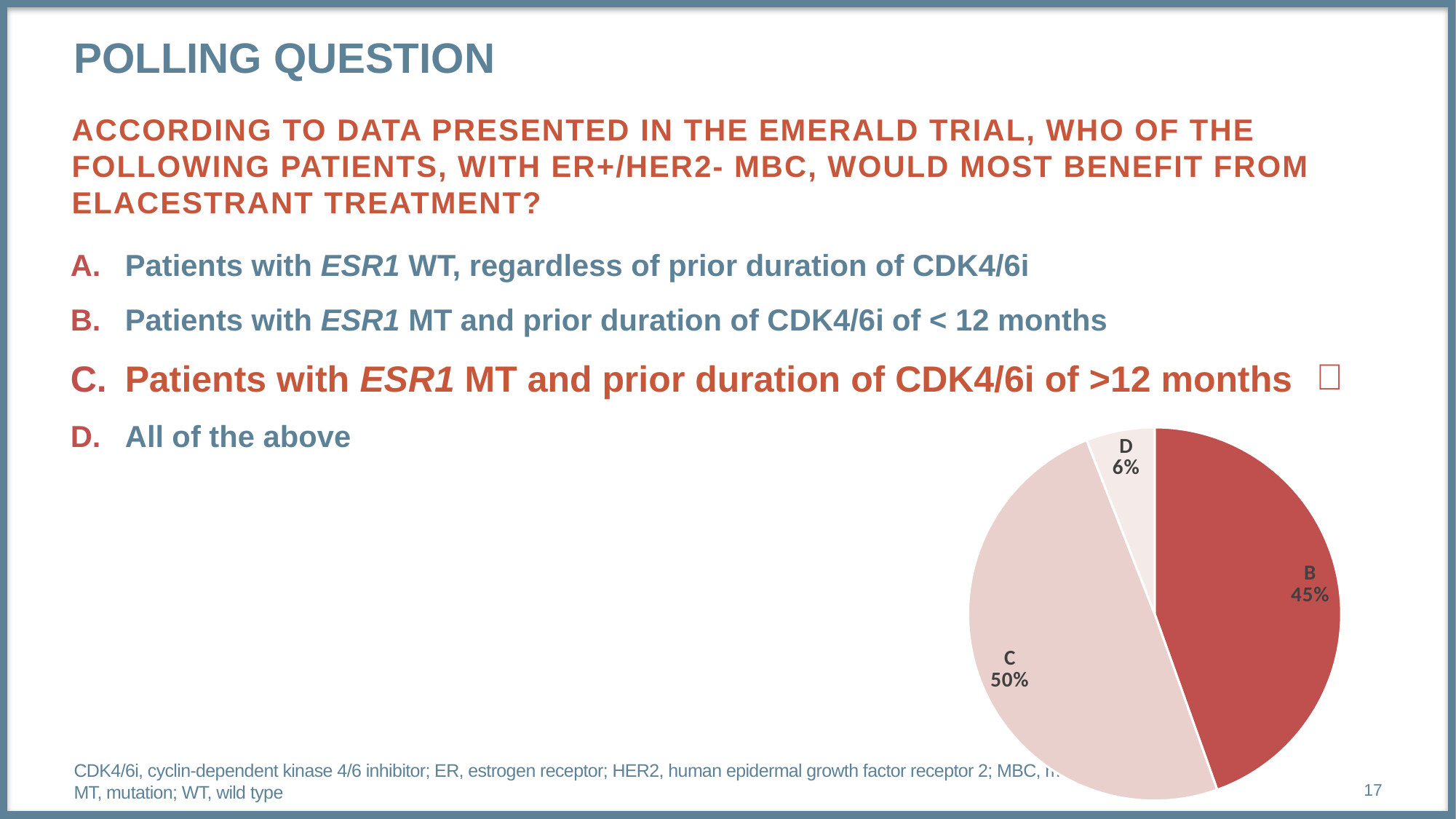
What kind of chart is shown on the slide? pie chart What share of the pie chart does option D have? 6% Which slice is larger in the pie chart, C or B? C What share of the pie chart does option B have? 45% How many slices are labelled in the pie chart? 3 Which option has the smallest slice in the pie chart? D What is the difference in percentage points between the slices for B and D? 39% Which slice is larger in the pie chart, B or D? B What is the difference in percentage points between the slices for C and B? 5% Which option has the largest slice in the pie chart? C What share of the pie chart does option C have? 50% Which slice of the pie chart is coloured dark red? B